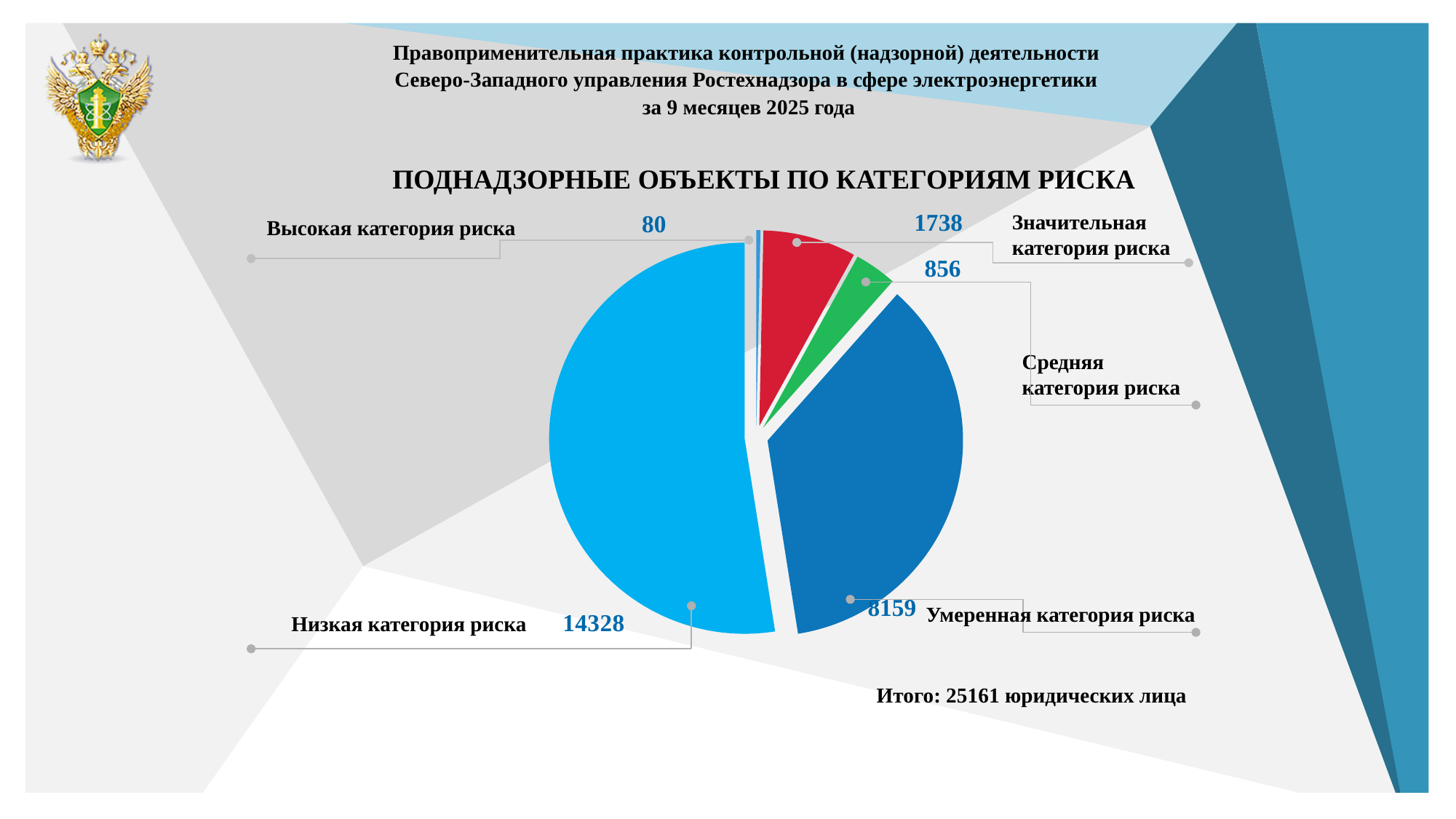
Which category has the smallest value? Высокая категория риска What is the difference between Низкая категория риска and Умеренная категория риска? 6169 Which is larger, Значительная категория риска or Средняя категория риска? Значительная категория риска Which category has the largest value? Низкая категория риска What is the value for Значительная категория риска? 1738 What total number of legal entities is stated below the chart? 25161 What is the value for Умеренная категория риска? 8159 What is the value for Высокая категория риска? 80 What is the value for Средняя категория риска? 856 How many categories does the pie chart show? 5 What is the value for Низкая категория риска? 14328 What kind of chart is shown on the slide? pie chart